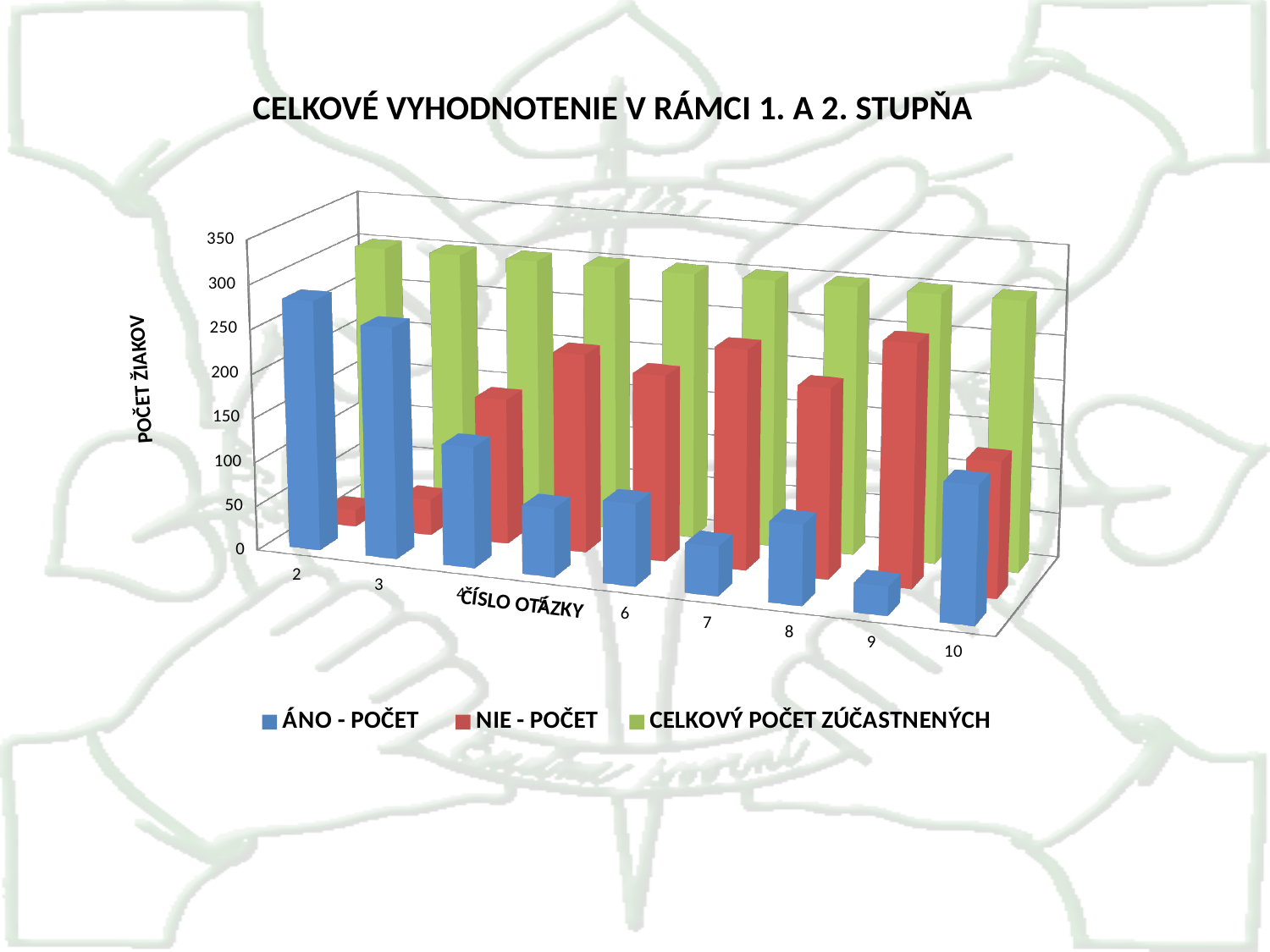
For which question number is the ÁNO - POČET value lowest? 9 What kind of chart is shown on the slide? bar chart For which question number is the ÁNO - POČET value highest? 2 What is the title of the chart? CELKOVÉ VYHODNOTENIE V RÁMCI 1. A 2. STUPŇA How many series does the legend list? 3 How many question numbers (categories) are shown on the x axis? 9 For which question number is the NIE - POČET value highest? 9 For question 9, which is larger: ÁNO - POČET or NIE - POČET? NIE - POČET For question 2, which is larger: ÁNO - POČET or NIE - POČET? ÁNO - POČET Is the NIE - POČET value for question 2 greater or less than 100? less Is the ÁNO - POČET value for question 2 greater or less than 200? greater Is the ÁNO - POČET value for question 9 greater or less than 100? less